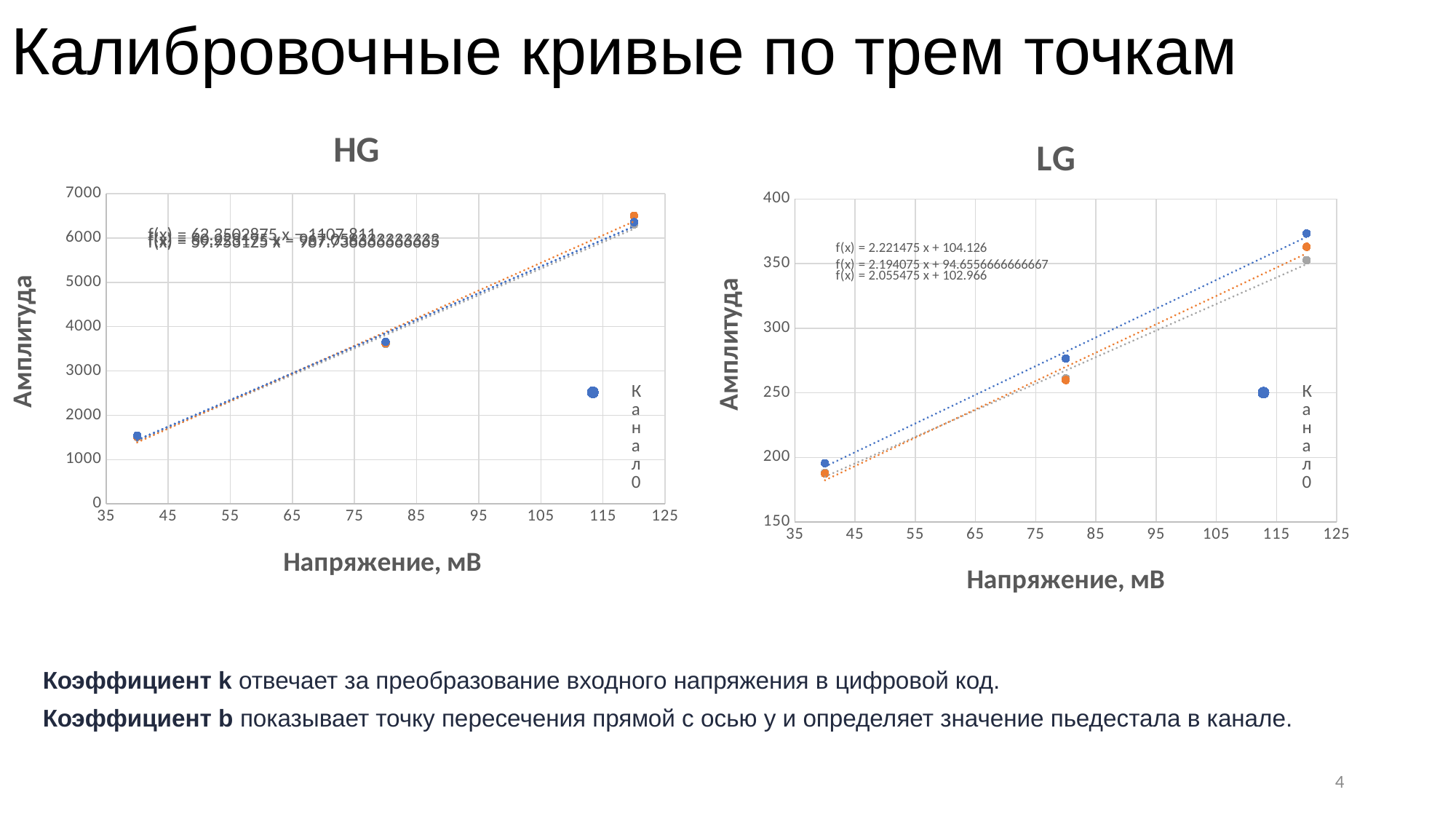
On the LG chart, how many data points does each series have? 3 On the HG chart, do the amplitude values rise or fall as the voltage increases? rise On the HG chart, is the amplitude at 40 mV greater or less than 2000? less On the LG chart, what is the slope in the first trendline equation, f(x) = ? x + 104.126? 2.221475 What kind of chart is the HG chart? scatter chart On the HG chart, is the amplitude at 80 mV greater or less than 3000? greater What is the x-axis title of the LG chart? Напряжение, мВ On the LG chart, is the amplitude at 80 mV greater or less than 250? greater On the LG chart, do the amplitude values rise or fall as the voltage increases? rise On the HG chart, how many data points does each series have? 3